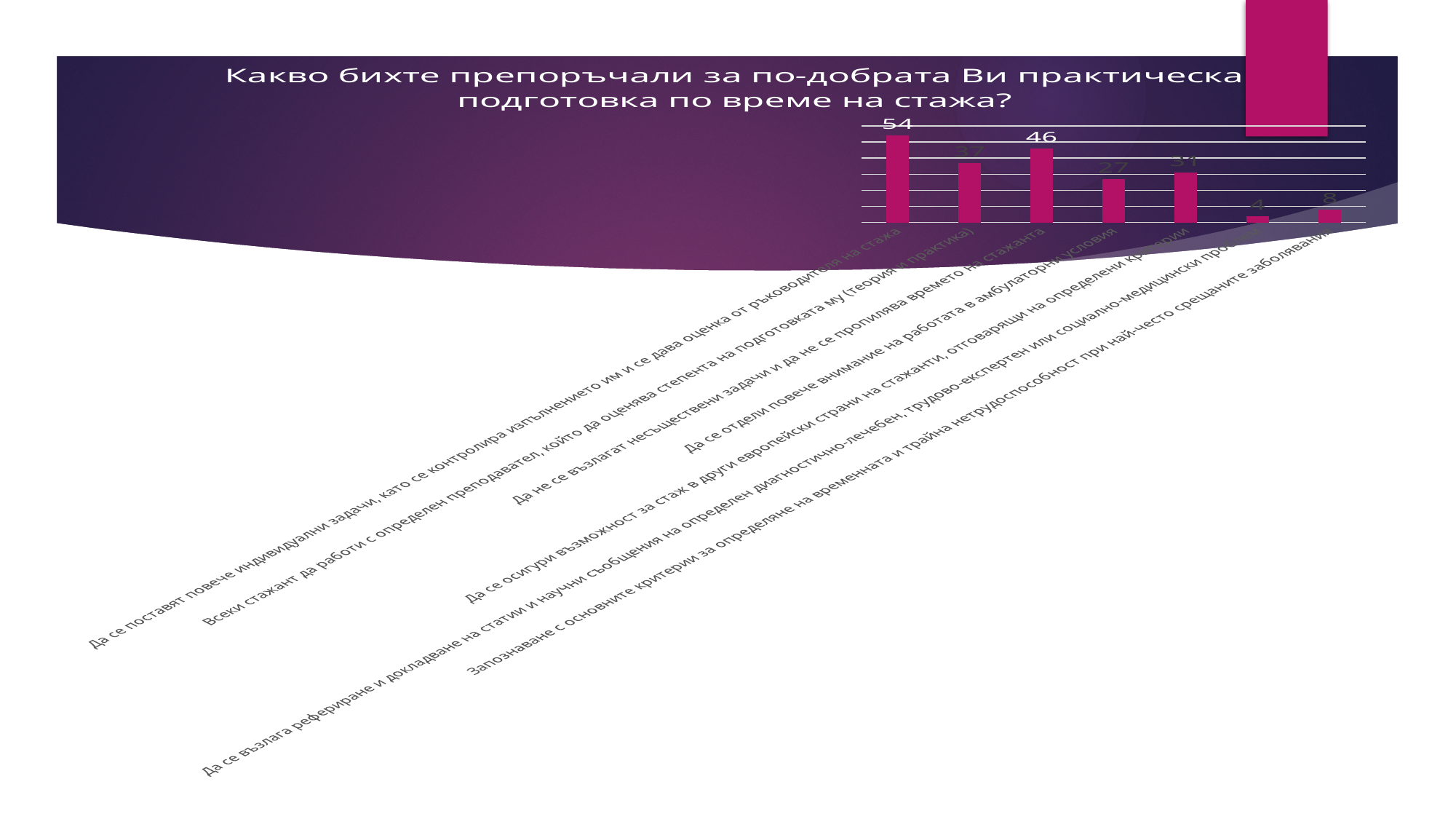
What is the value for the category "Да не се възлагат несъществени задачи и да не се пропилява времето на стажанта"? 46 How many categories (bars) does the chart show? 7 What type of chart is shown on the slide? bar chart What is the value for the category "Запознаване с основните критерии за определяне на временната и трайна нетрудоспособност..."? 8 Which category has the highest value? Да се поставят повече индивидуални задачи, като се контролира изпълнението им и се дава оценка от ръководителя на стажа What is the value for the category "Всеки стажант да работи с определен преподавател..."? 37 What is the value for the category "Да се отдели повече внимание на работата в амбулаторни условия"? 27 Which is larger: the value for "Да се осигури възможност за стаж в други европейски страни..." or the value for "Да се отдели повече внимание на работата в амбулаторни условия"? Да се осигури възможност за стаж в други европейски страни... What is the value for the category "Да се поставят повече индивидуални задачи..."? 54 Which category has the lowest value? Да се възлага рефериране и докладване на статии и научни съобщения... What is the title of the chart? Какво бихте препоръчали за по-добрата Ви практическа подготовка по време на стажа? What is the difference between the highest value (54) and the value for "Да не се възлагат несъществени задачи..." (46)? 8